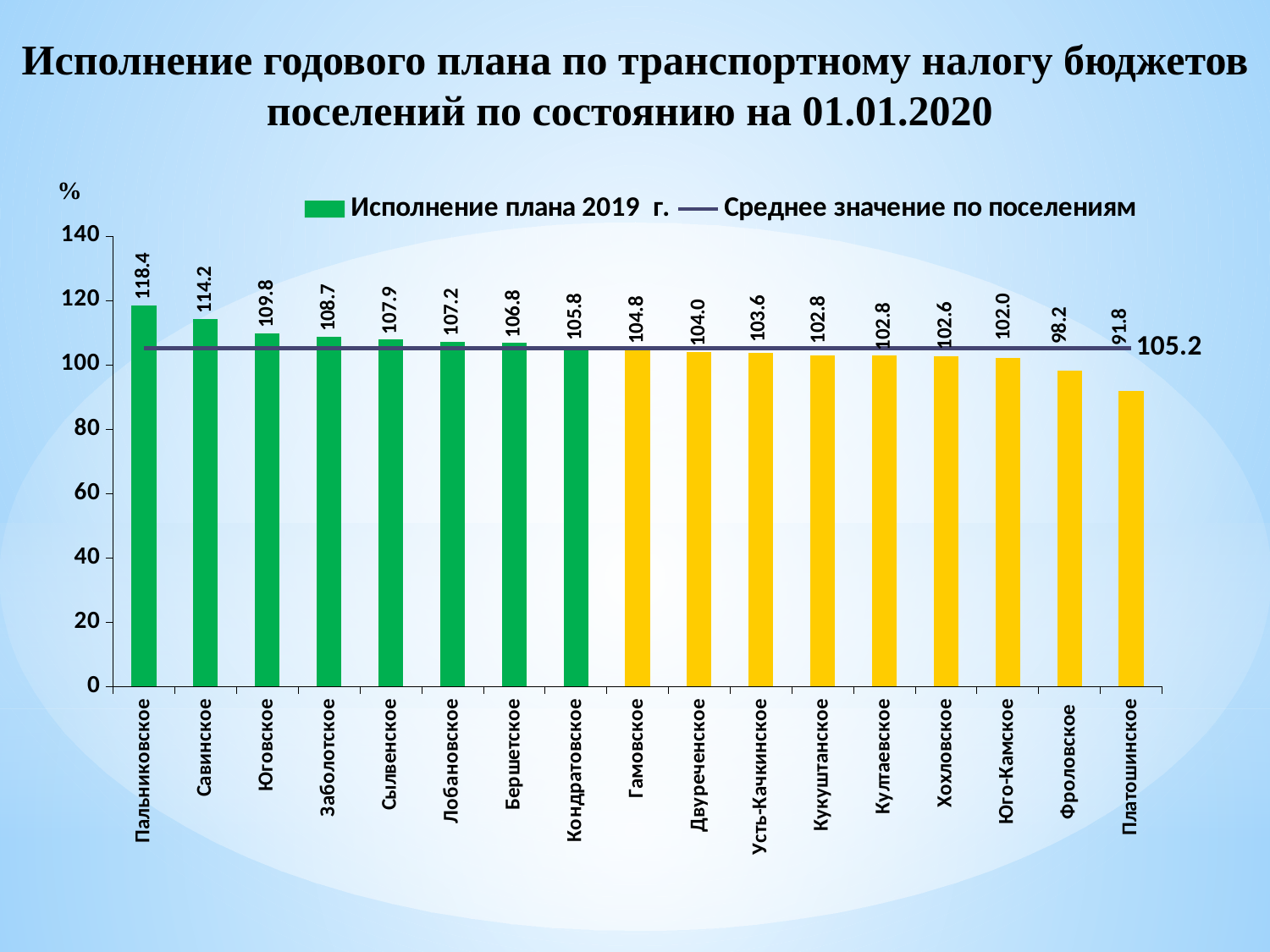
Is the value for Платошинское greater or less than 100? less What kind of chart is shown on the slide? bar chart What is the value for Пальниковское? 118.4 Which settlement has the highest value? Пальниковское What is the difference between the values for Пальниковское and Савинское? 4.2 How many settlements are shown on the chart? 17 How many entries does the legend list? 2 What is the value for Платошинское? 91.8 Which is larger, the value for Юговское or the value for Фроловское? Юговское Which settlement has the lowest value? Платошинское What is the value of the average line (Среднее значение по поселениям)? 105.2